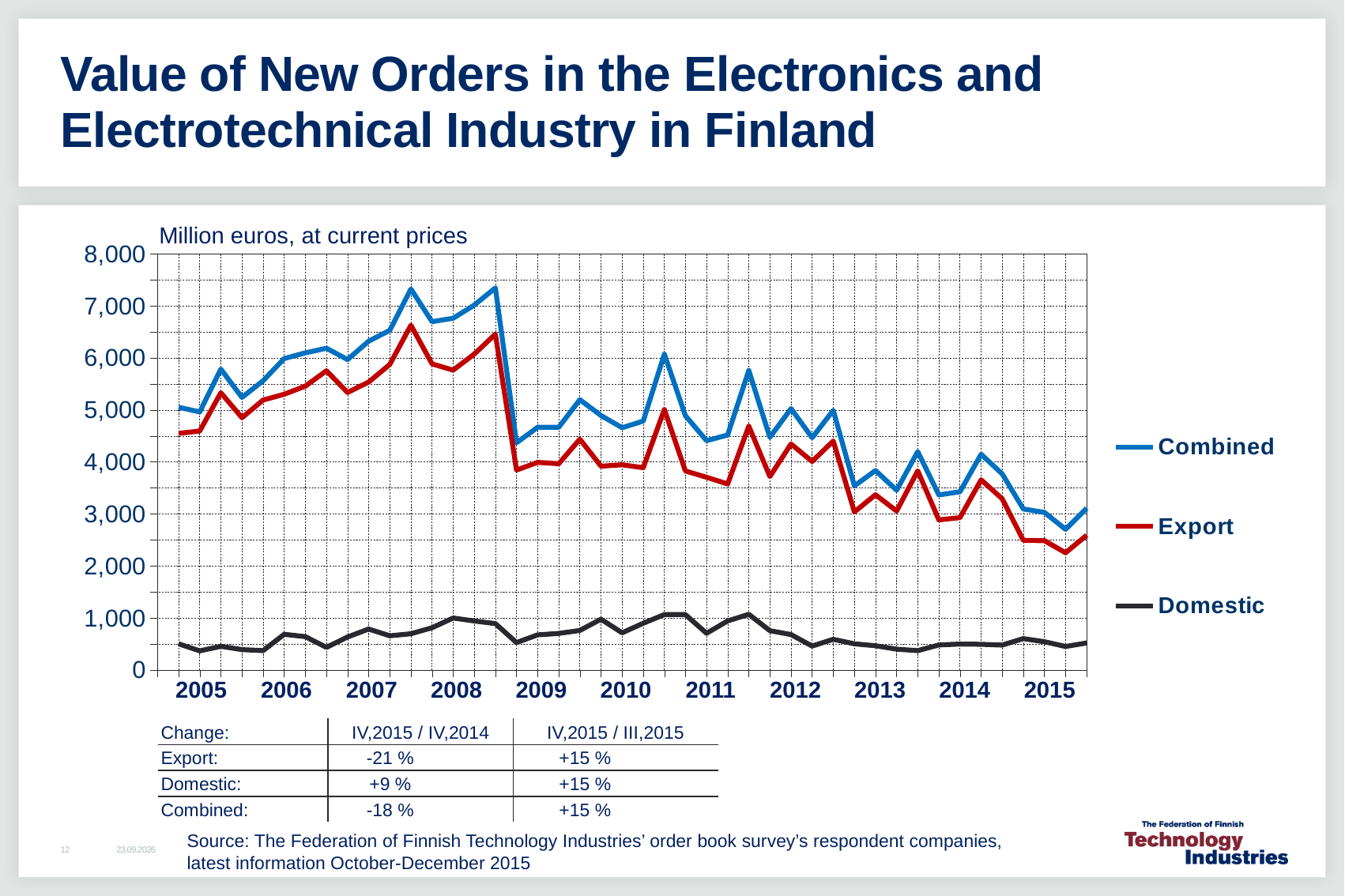
How many years are labelled on the x axis? 11 Which is larger in 2010, the Combined series or the Domestic series? Combined Is the Domestic series ever greater or less than 2,000 across the whole chart? less What unit label is shown above the chart's y axis? Million euros, at current prices Which series has the highest values throughout the chart? Combined What kind of chart is shown on the slide? line chart Does the Combined series generally rise or fall from 2012 to 2015? fall Which series is plotted with the red line? Export Is the peak value of the Combined series in 2008 greater or less than 7,000? greater How many series does the legend list? 3 Is the value of the Export series at the end of 2015 greater or less than 3,000? less Which series has the lowest values throughout the chart? Domestic